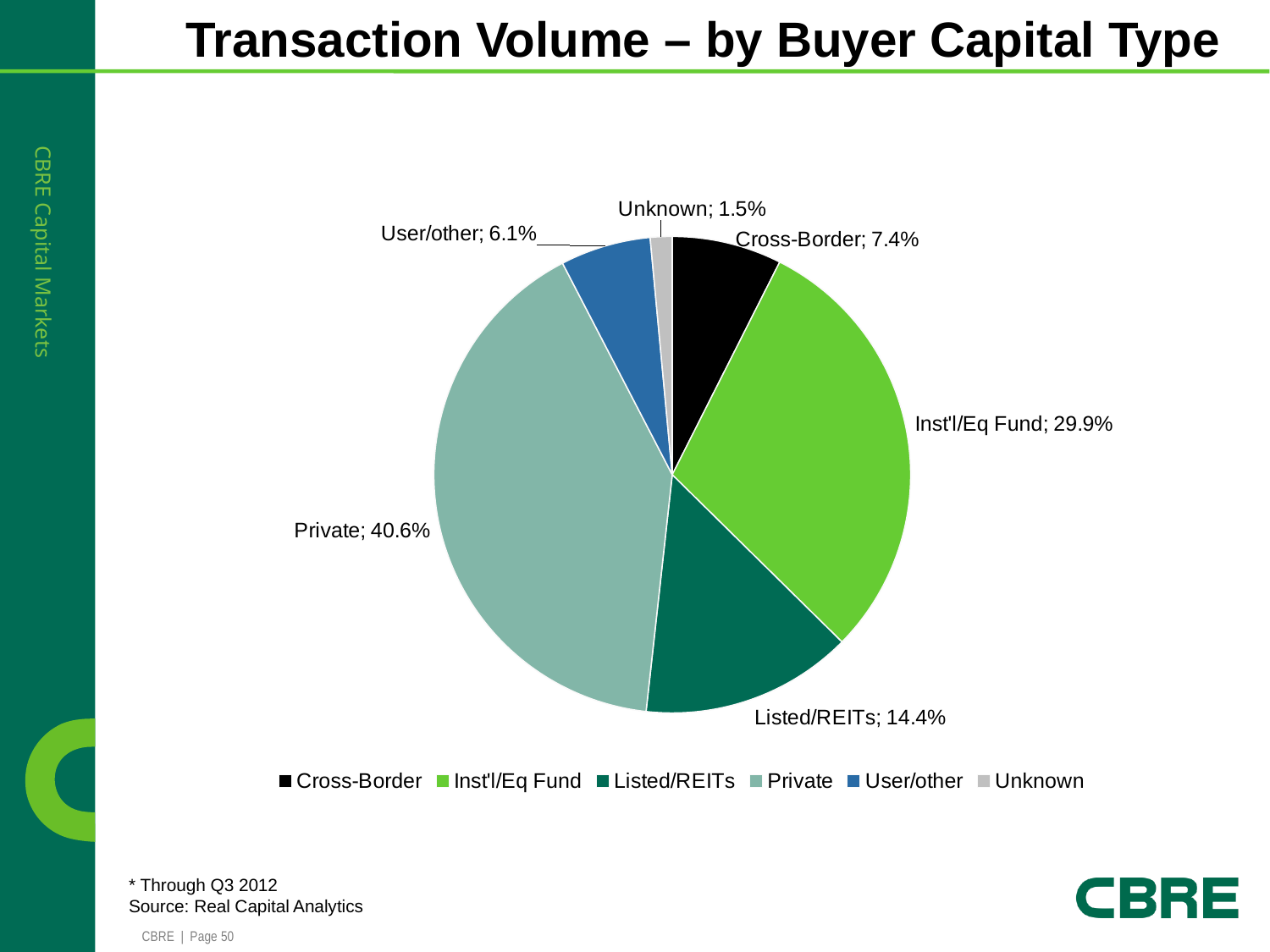
What is the value shown for Inst'l/Eq Fund? 29.9% What kind of chart is shown on the slide? pie chart What is the title of the chart? Transaction Volume – by Buyer Capital Type What percentage is shown for Listed/REITs? 14.4% Which buyer capital type has the smallest slice of the pie? Unknown Which buyer capital type has the largest slice of the pie? Private How many buyer capital types are shown in the pie chart? 6 Which is larger, the share for Cross-Border or the share for User/other? Cross-Border What is the value for Cross-Border? 7.4% What share is labelled for User/other? 6.1% What share of transaction volume is attributed to Private buyers? 40.6% What is the difference in percentage points between Private and Inst'l/Eq Fund? 10.7